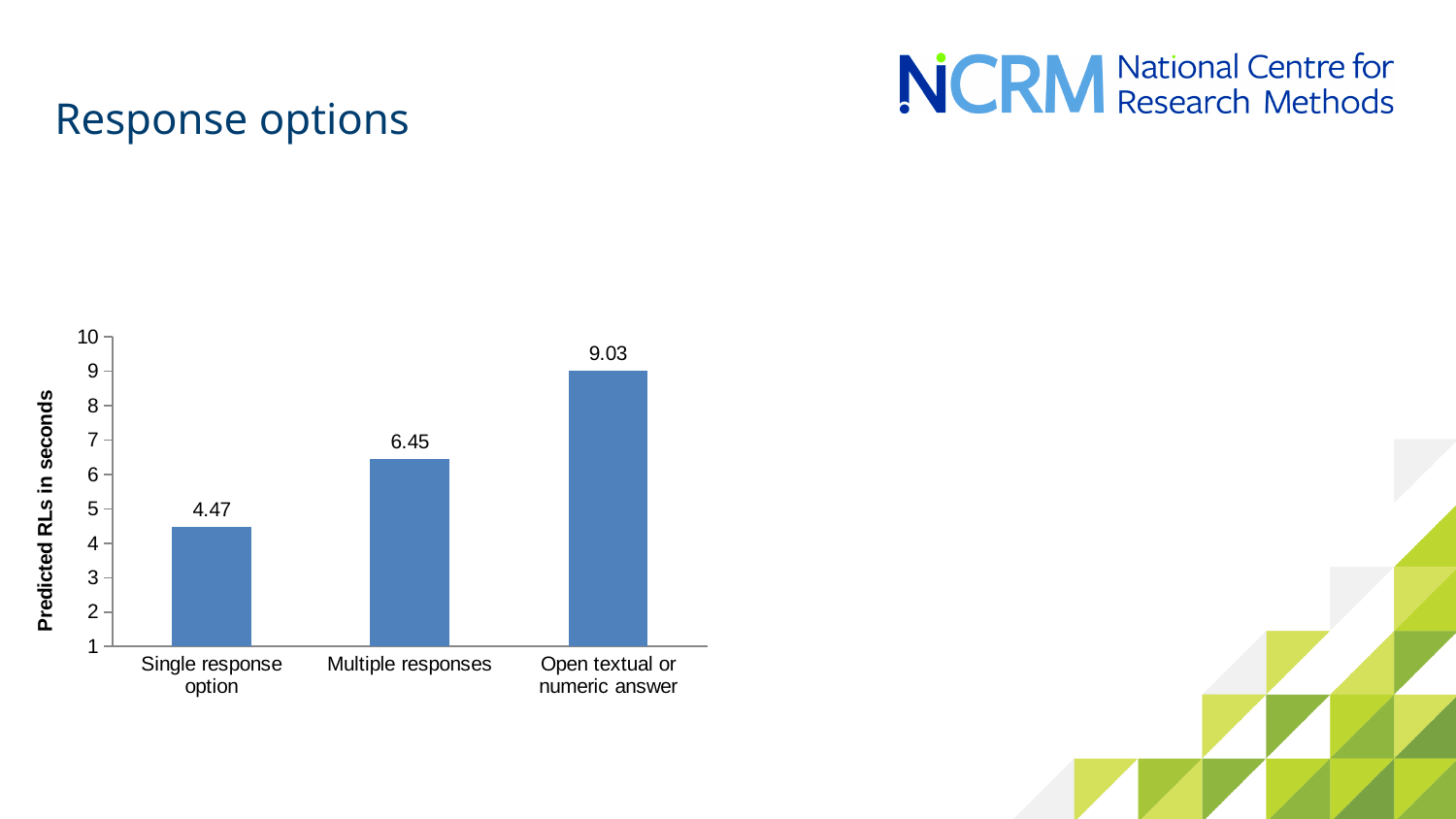
Is the value for Multiple responses greater or less than 6? greater What kind of chart is shown on the slide? Bar chart What is the predicted RLs in seconds for Open textual or numeric answer? 9.03 Which has a larger predicted RLs, Multiple responses or Single response option? Multiple responses What is the predicted RLs in seconds for Multiple responses? 6.45 What is the difference in predicted RLs between Open textual or numeric answer and Single response option? 4.56 What is the difference in predicted RLs between Multiple responses and Single response option? 1.98 What is the predicted RLs in seconds for Single response option? 4.47 Which response option has the lowest predicted RLs? Single response option How many categories are shown on the x axis of the chart? 3 What is the label of the y axis of the chart? Predicted RLs in seconds Which response option has the highest predicted RLs? Open textual or numeric answer